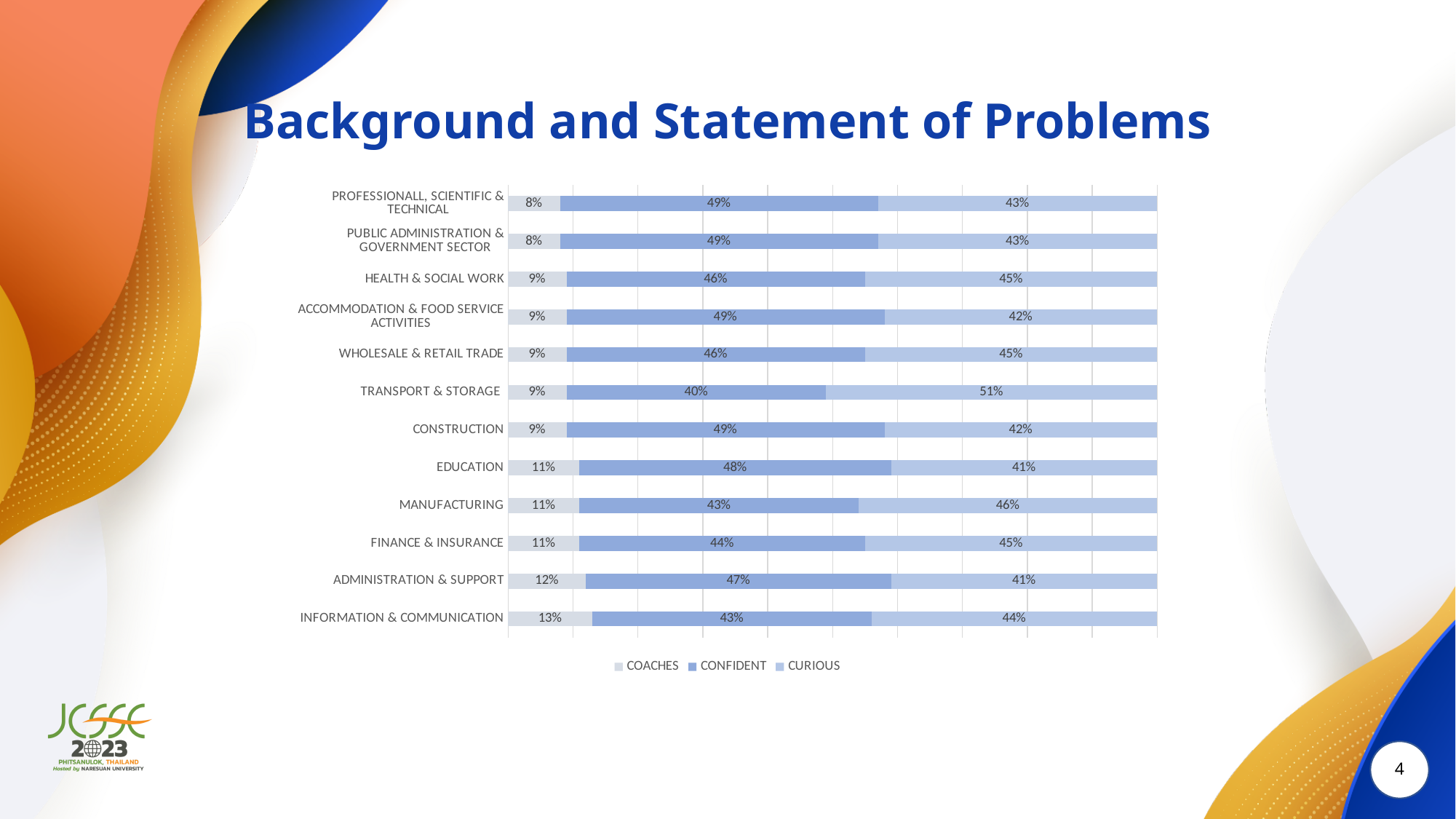
How many series does the legend list? 3 How many categories are shown on the chart? 12 What kind of chart is shown on the slide? Stacked bar chart What is the difference between the CURIOUS and CONFIDENT values for TRANSPORT & STORAGE? 11% Which category has the highest CURIOUS value? TRANSPORT & STORAGE What are the three series listed in the legend? COACHES, CONFIDENT, CURIOUS What is the CURIOUS value for MANUFACTURING? 46% Which category has the highest COACHES value? INFORMATION & COMMUNICATION Which category has the lowest CONFIDENT value? TRANSPORT & STORAGE Which is larger for EDUCATION: the CONFIDENT value or the CURIOUS value? CONFIDENT What is the COACHES value for INFORMATION & COMMUNICATION? 13% What is the CONFIDENT value for TRANSPORT & STORAGE? 40%